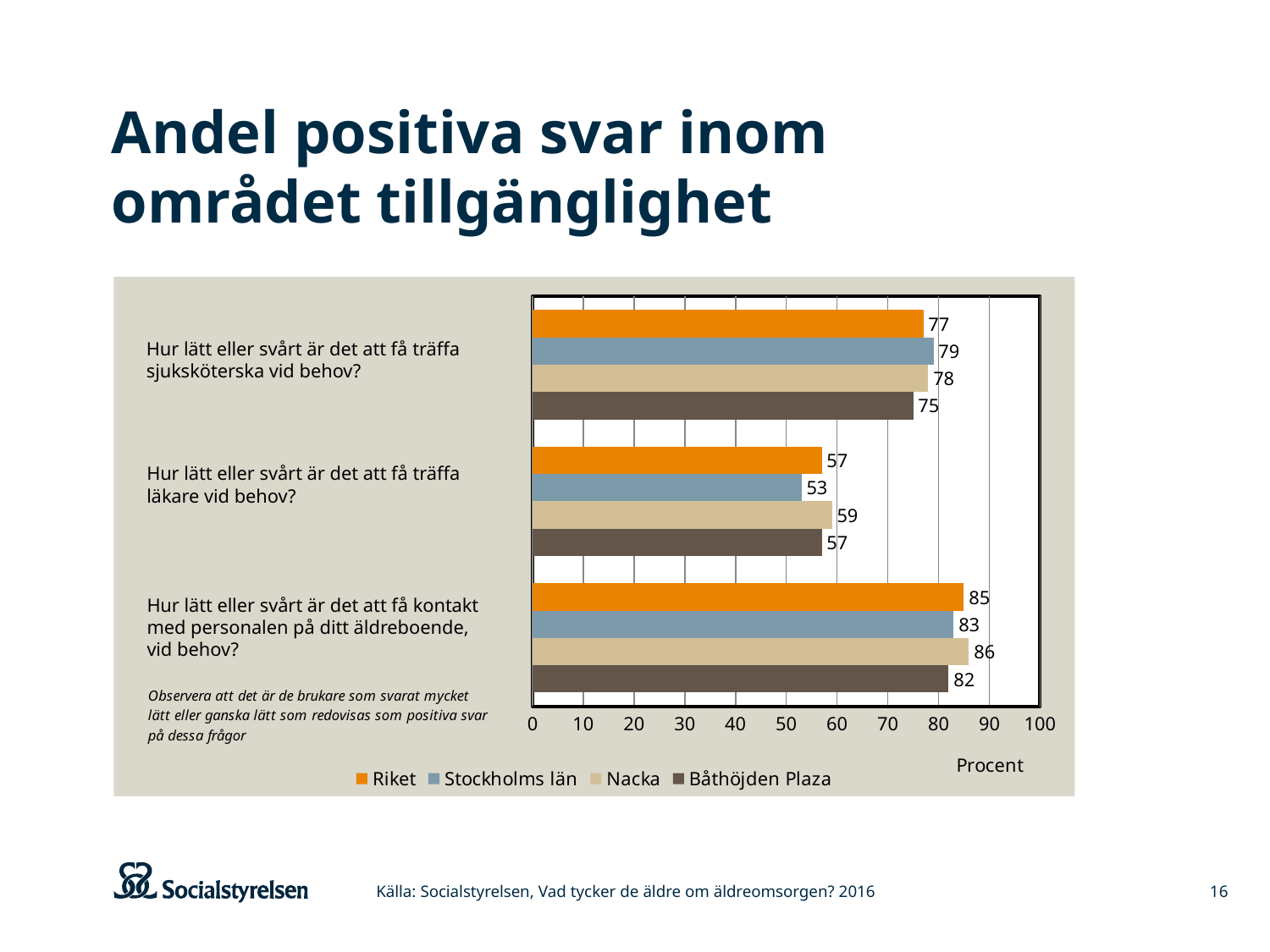
What is the value for Riket on the question about meeting a nurse when needed ("Hur lätt eller svårt är det att få träffa sjuksköterska vid behov?")? 77 Which series has the highest value on the question about meeting a nurse when needed? Stockholms län What is the difference between the Nacka and Stockholms län values on the question about meeting a doctor when needed? 6 How many series does the legend list? 4 What is the value for Stockholms län on the question about meeting a doctor when needed? 53 What kind of chart is shown on the slide? Bar chart Which is larger on the question about getting in contact with staff: the value for Riket or the value for Stockholms län? Riket How many question categories are shown on the chart? 3 Which series has the lowest value on the question about getting in contact with staff at the care home? Båthöjden Plaza What unit is shown on the horizontal axis of the chart? Procent What is the value for Nacka on the question about getting in contact with staff at the care home ("Hur lätt eller svårt är det att få kontakt med personalen på ditt äldreboende, vid behov?")? 86 What is the value for Båthöjden Plaza on the question about meeting a doctor when needed ("Hur lätt eller svårt är det att få träffa läkare vid behov?")? 57